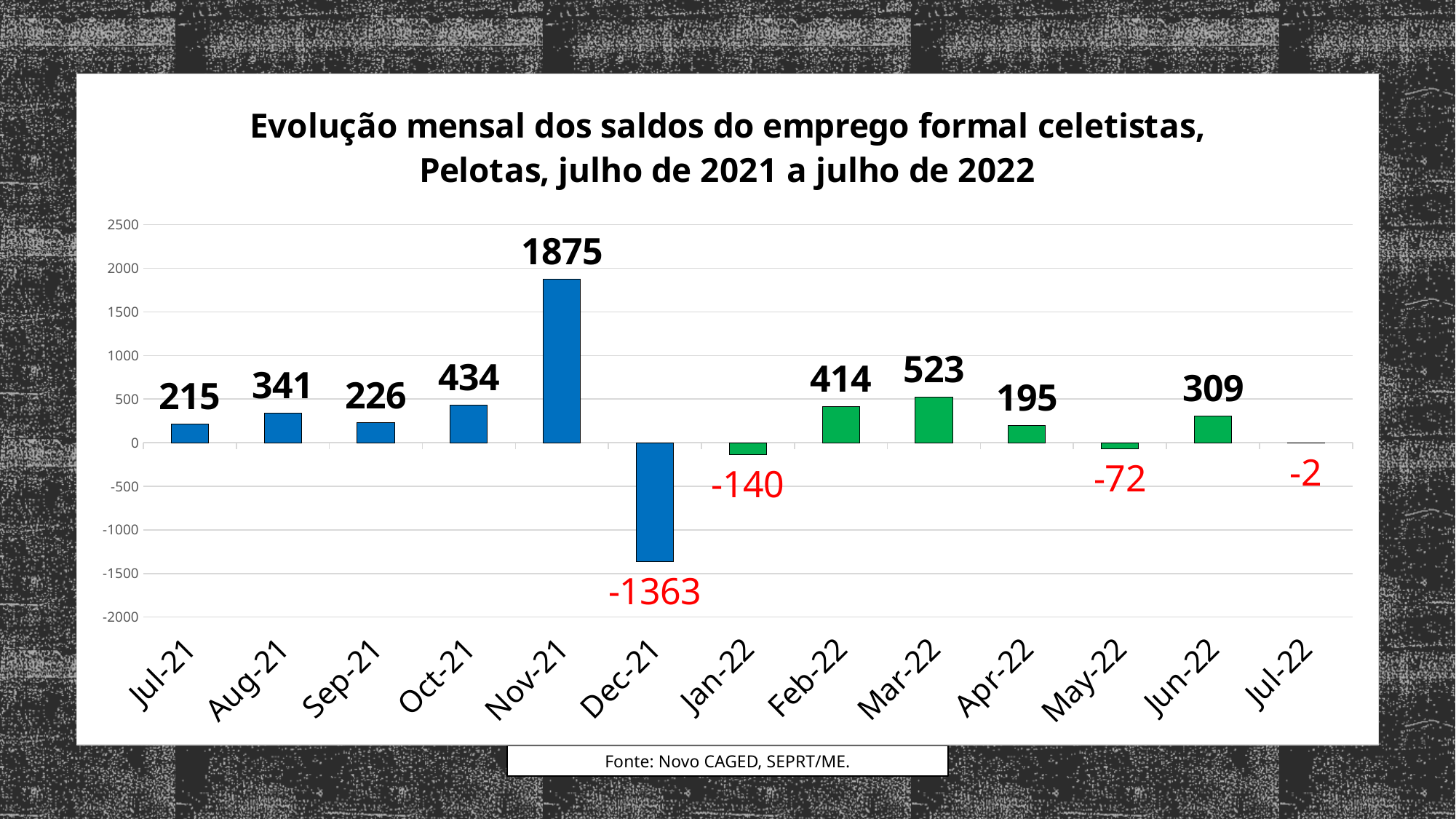
How many months are shown on the x axis? 13 What is the value for Dec-21? -1363 What source is cited below the chart? Novo CAGED, SEPRT/ME. Is the value for Nov-21 greater or less than 1500? greater Which month has the lowest value? Dec-21 What is the difference between the values for Oct-21 and Sep-21? 208 What is the value for Mar-22? 523 What kind of chart is shown on the slide? bar chart What is the value for Nov-21? 1875 Which month has the highest value? Nov-21 Which is larger, the value for Feb-22 or the value for Jun-22? Feb-22 What is the value for Jul-22? -2